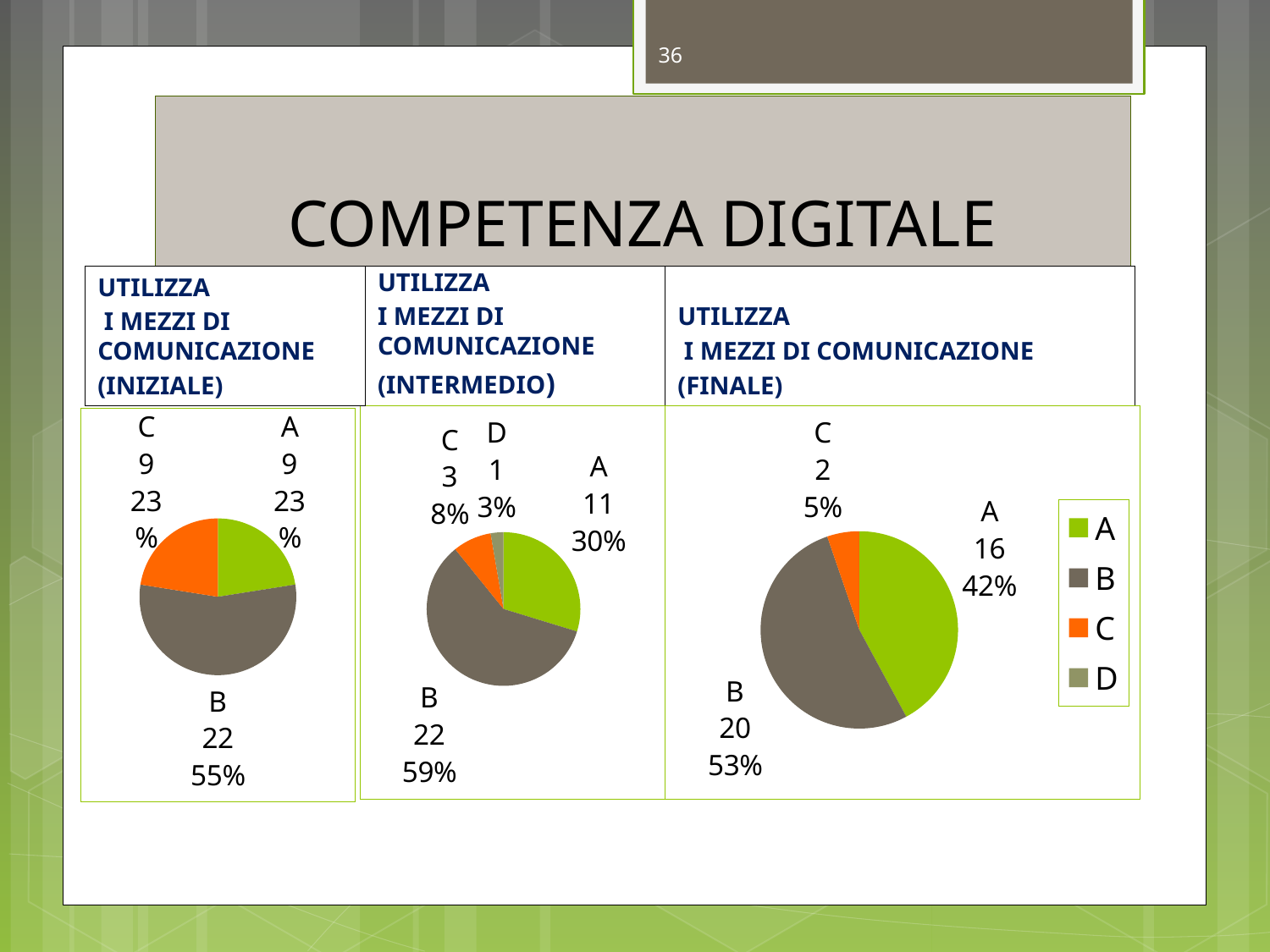
In the INTERMEDIO pie chart, which category has the smallest slice? D In the FINALE pie chart, what share of the pie does slice B represent? 53% How many slices does the INTERMEDIO pie chart have? 4 In the FINALE pie chart, which is larger, the value for A or the value for C? A In the INTERMEDIO pie chart, what is the value for A? 11 In the INTERMEDIO pie chart, which category has the largest slice? B In the INIZIALE pie chart, what share of the pie does slice A represent? 23% In the INTERMEDIO pie chart, what share of the pie does slice D represent? 3% In the FINALE pie chart, what is the difference between the values for B and A? 4 How many entries does the legend of the FINALE pie chart list? 4 In the FINALE pie chart, what is the value for A? 16 In the INIZIALE pie chart, what is the value for B? 22